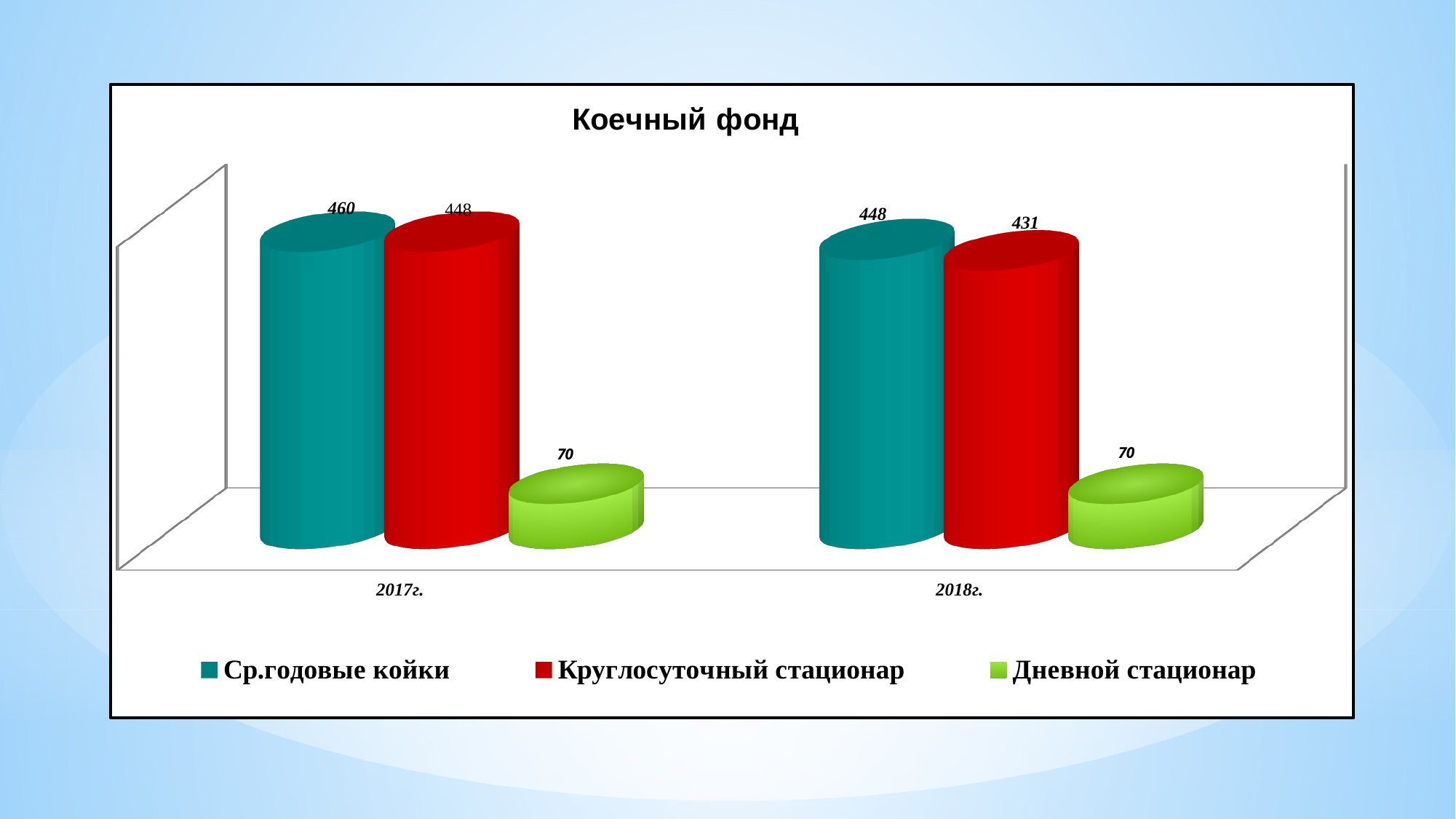
What is the value for Ср.годовые койки in 2017г.? 460 Which series has the lowest value in 2018г.? Дневной стационар What is the value for Ср.годовые койки in 2018г.? 448 What is the difference between Ср.годовые койки in 2017г. and in 2018г.? 12 What is the value for Круглосуточный стационар in 2018г.? 431 What is the difference between Круглосуточный стационар in 2017г. and in 2018г.? 17 How many series does the legend list? 3 What is the title of the chart? Коечный фонд What kind of chart is shown? Bar chart Which is larger: Круглосуточный стационар in 2017г. or in 2018г.? 2017г. Which series has the highest value in 2017г.? Ср.годовые койки What is the value for Дневной стационар in 2017г.? 70